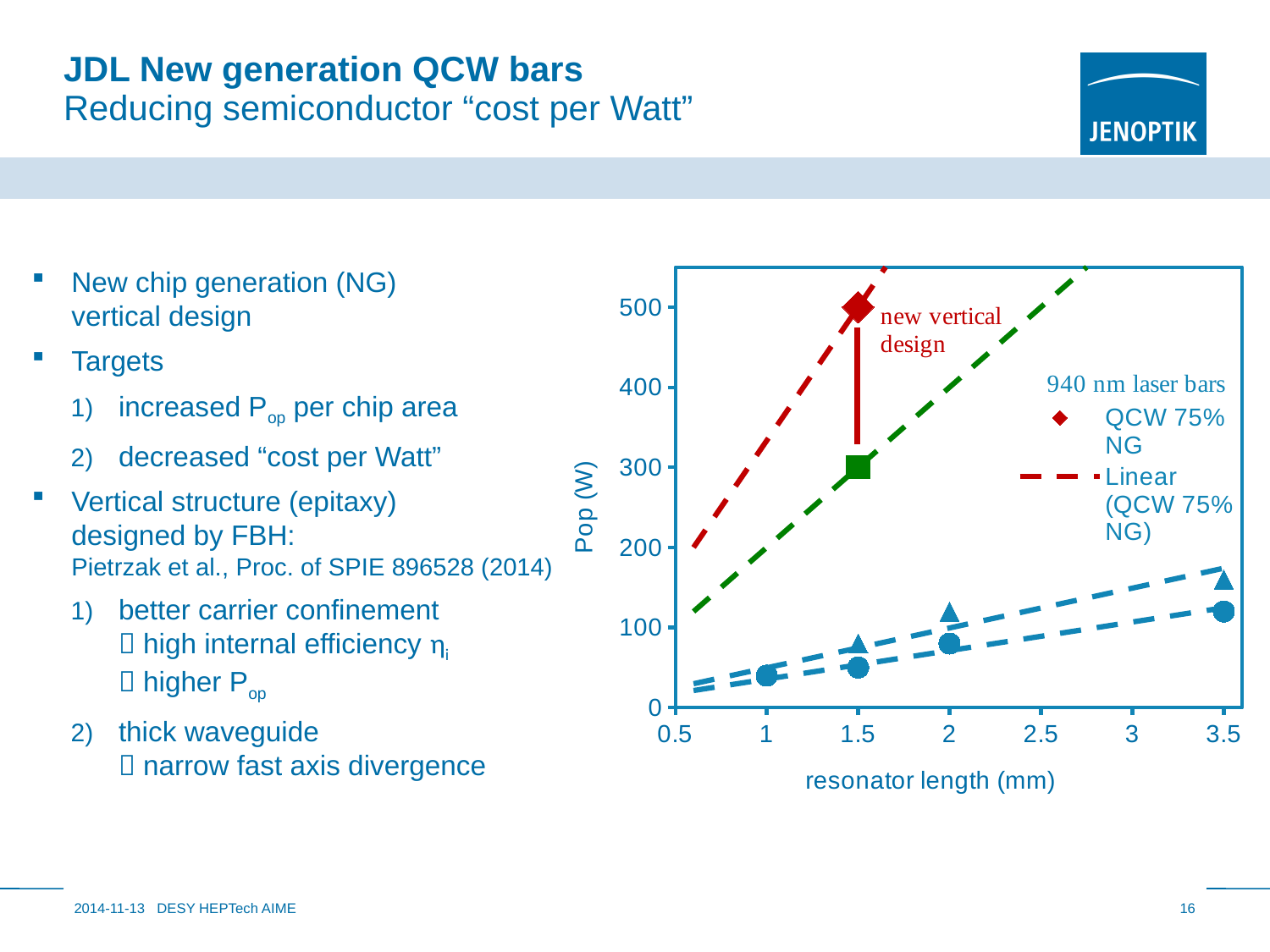
How many entries does the chart legend list? 2 Is the Pop (W) value of the blue circle point at 1 mm greater or less than 100? less What is the difference in Pop (W) between the red diamond (QCW 75% NG) point and the green square point at 1.5 mm? 200 Which point has the highest Pop (W) value on the chart? the red diamond (QCW 75% NG) at 1.5 mm What is the Pop (W) value of the red diamond (QCW 75% NG) point at a resonator length of 1.5 mm? 500 What kind of chart is shown on the slide? scatter chart Is the Pop (W) value of the blue triangle point at 3.5 mm greater or less than 200? less What is the Pop (W) value of the green square point at a resonator length of 1.5 mm? 300 What heading appears above the legend entries in the chart? 940 nm laser bars Do the blue circle values rise or fall as resonator length increases? rise What is the label of the x axis of the chart? resonator length (mm) At a resonator length of 1.5 mm, which is larger: the red diamond (QCW 75% NG) point or the green square point? the red diamond (QCW 75% NG)